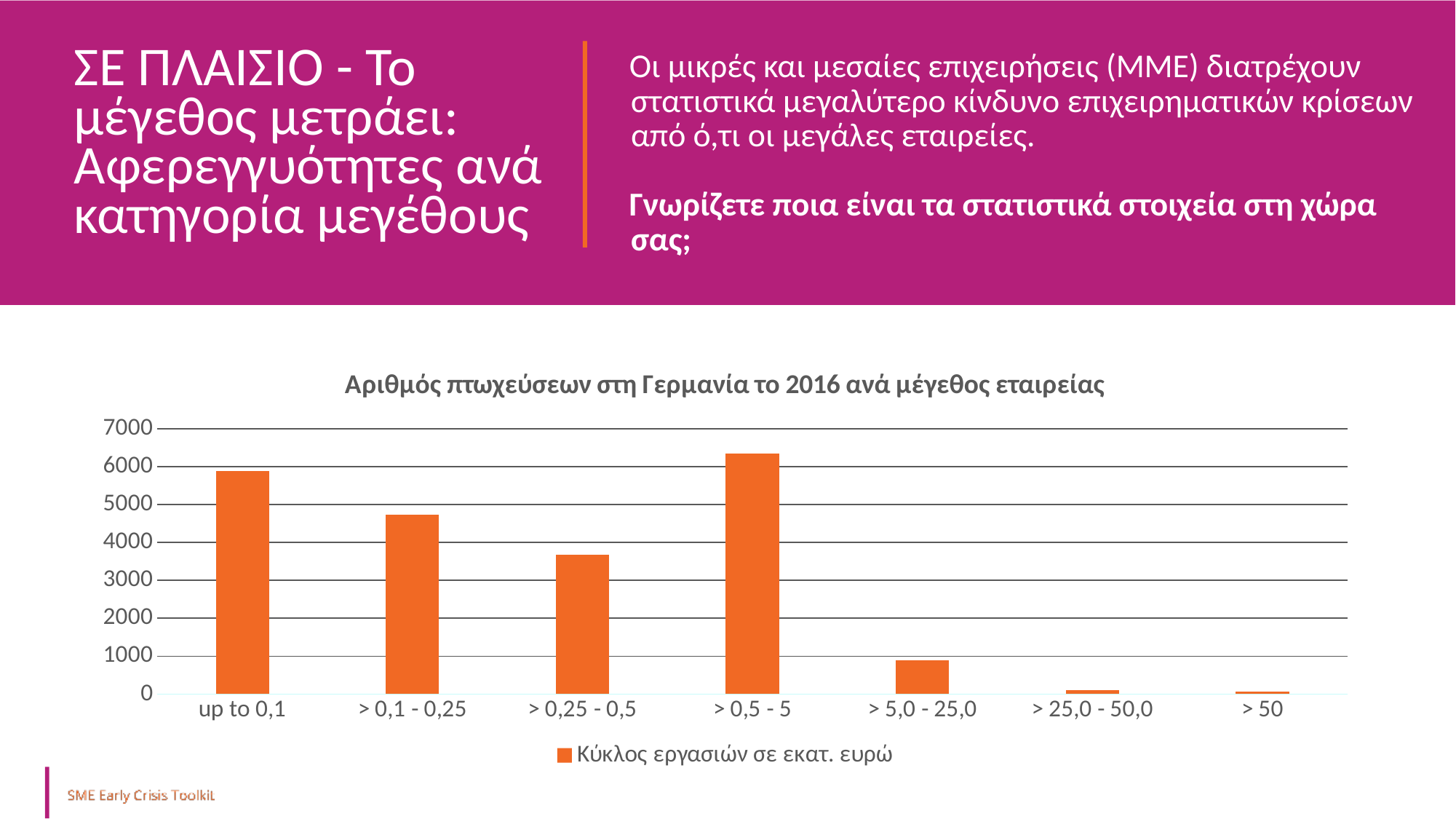
Is the value for '> 0,5 - 5' greater or less than 6000? greater What is the legend entry for the series in the chart? Κύκλος εργασιών σε εκατ. ευρώ Is the value for '> 0,1 - 0,25' greater or less than 5000? less Is the value for 'up to 0,1' greater or less than 5000? greater How many categories are shown on the x axis of the chart? 7 Which category has the highest value in the chart? > 0,5 - 5 How many series does the chart's legend list? 1 What kind of chart is shown on the slide? bar chart Which is larger, the value for 'up to 0,1' or the value for '> 0,1 - 0,25'? up to 0,1 What is the title of the chart? Αριθμός πτωχεύσεων στη Γερμανία το 2016 ανά μέγεθος εταιρείας